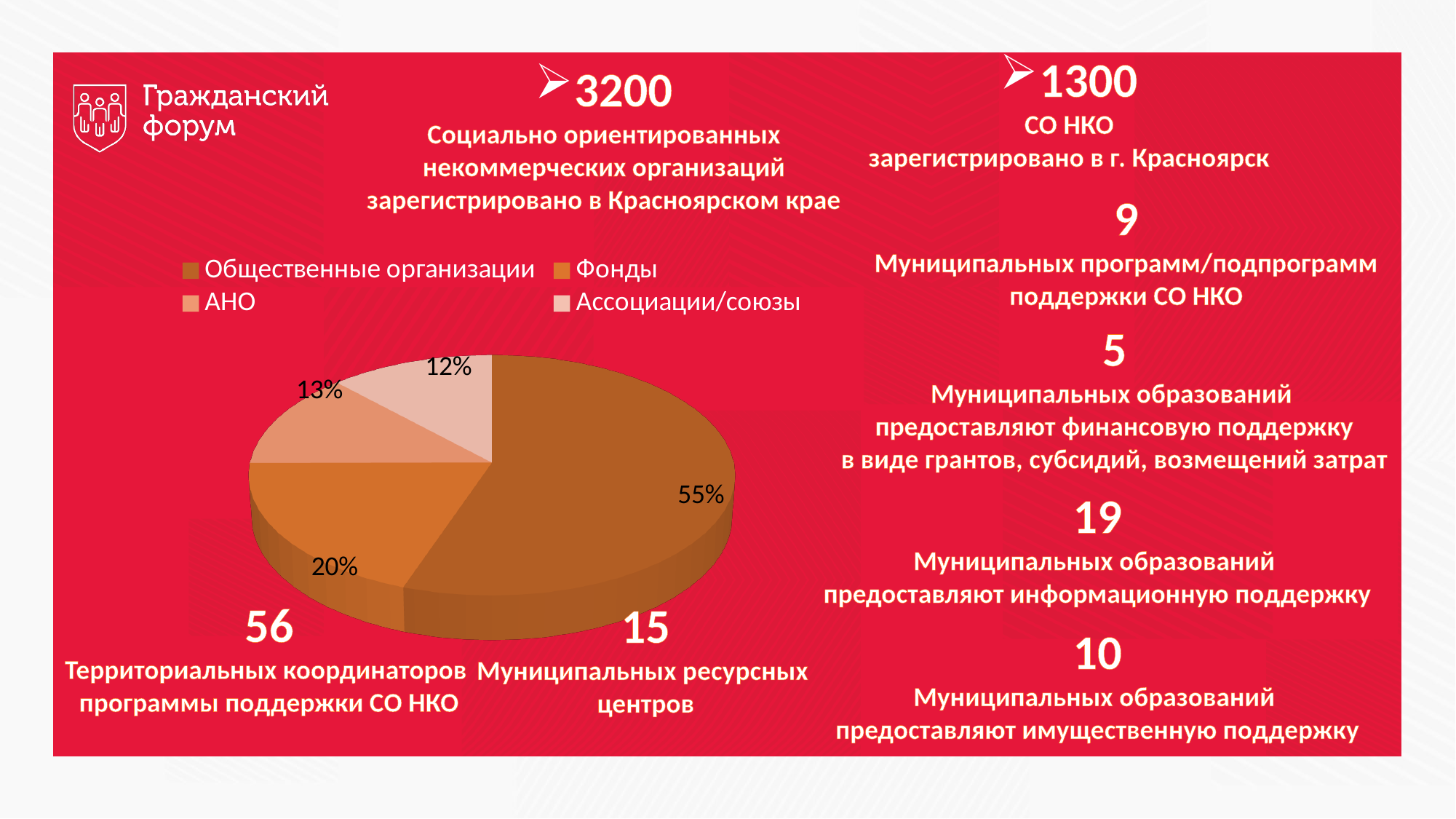
What is the difference in percentage points between Общественные организации and Фонды? 35 What type of chart is shown on the slide? pie chart What share of the pie does Фонды have? 20% Which category has the smallest slice of the pie? Ассоциации/союзы Which legend entry is shown in the darkest brown colour? Общественные организации What share of the pie does Общественные организации have? 55% How many entries does the legend of the pie chart list? 4 How many slices does the pie chart have? 4 Which is larger, the share for Фонды or the share for АНО? Фонды What share of the pie does АНО have? 13% What share of the pie does Ассоциации/союзы have? 12% Which category has the largest slice of the pie? Общественные организации